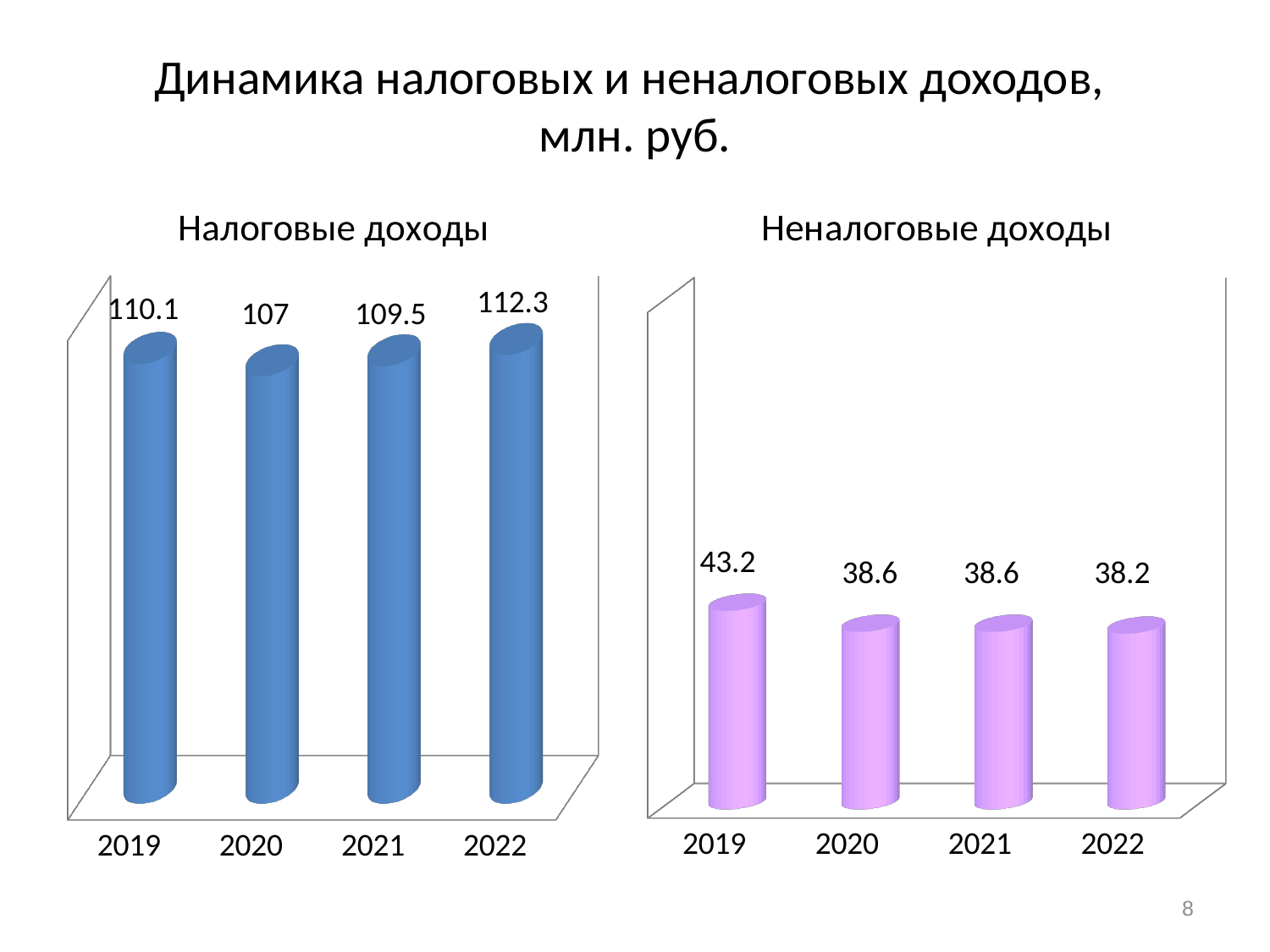
In the 'Неналоговые доходы' chart, what is the difference between the values for 2019 and 2022? 5 In the 'Налоговые доходы' chart, which year has the highest value? 2022 In the 'Неналоговые доходы' chart, what is the value for 2019? 43.2 In the 'Налоговые доходы' chart, what is the value for 2019? 110.1 In the 'Неналоговые доходы' chart, what is the value for 2022? 38.2 In the 'Налоговые доходы' chart, which year has the lowest value? 2020 In the 'Неналоговые доходы' chart, which year has the highest value? 2019 What kind of chart is the 'Налоговые доходы' chart? Bar chart How many years are shown in the 'Неналоговые доходы' chart? 4 In the 'Налоговые доходы' chart, what is the value for 2020? 107 In the 'Налоговые доходы' chart, which is larger, the value for 2021 or the value for 2022? 2022 In the 'Налоговые доходы' chart, what is the difference between the values for 2022 and 2020? 5.3